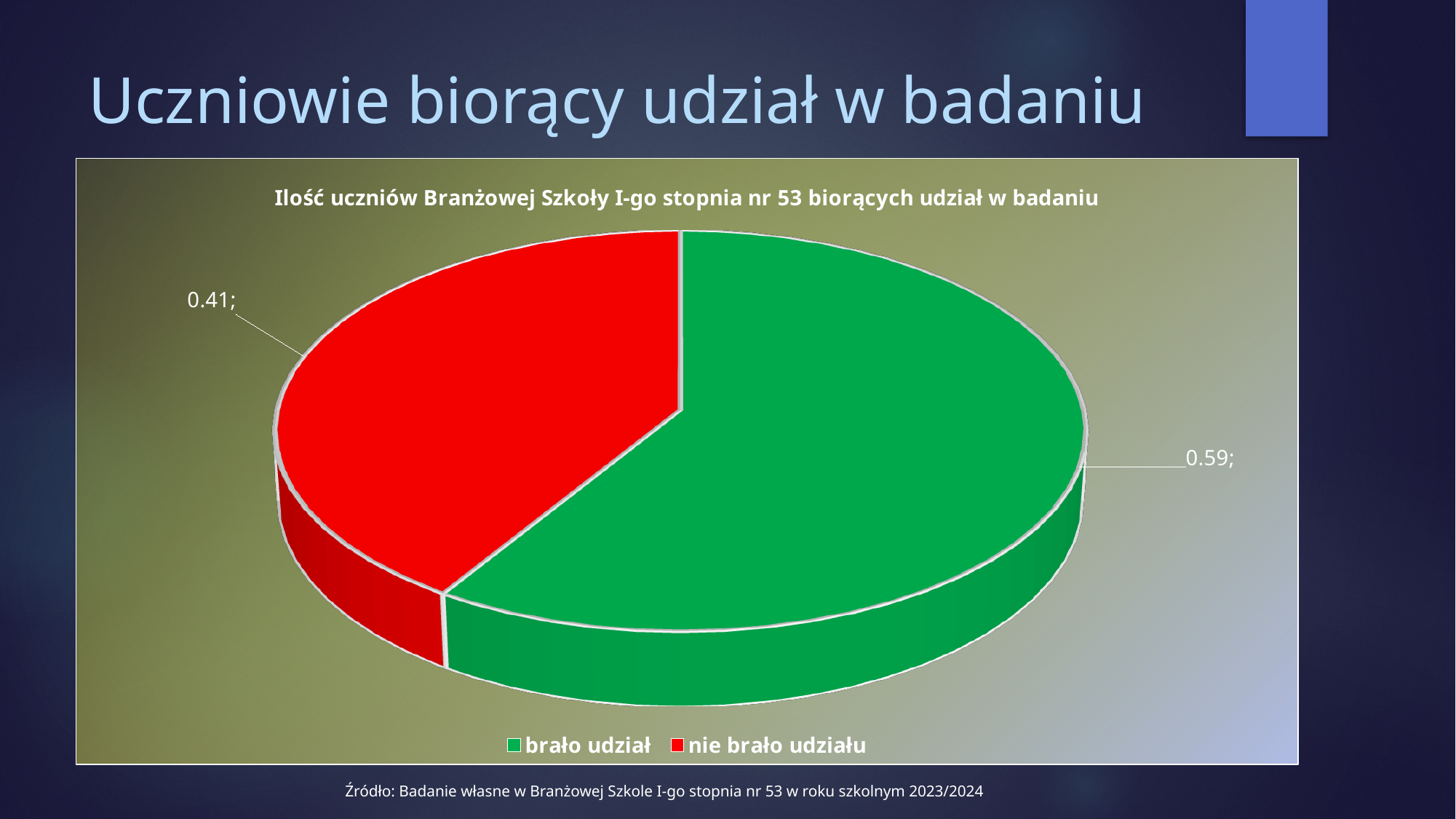
Which category has the smallest slice of the pie? nie brało udziału Which is larger: the slice for "brało udział" or the slice for "nie brało udziału"? brało udział What is the value shown for the "nie brało udziału" slice? 0.41 What colour is the "nie brało udziału" slice? Red What share of the pie does the "nie brało udziału" slice represent? 0.41 What kind of chart is shown on the slide? Pie chart What is the title of the chart? Ilość uczniów Branżowej Szkoły I-go stopnia nr 53 biorących udział w badaniu Which category has the largest slice of the pie? brało udział How many entries does the legend list? 2 What is the difference between the values for "brało udział" and "nie brało udziału"? 0.18 How many slices does the pie chart have? 2 What is the value shown for the "brało udział" slice? 0.59